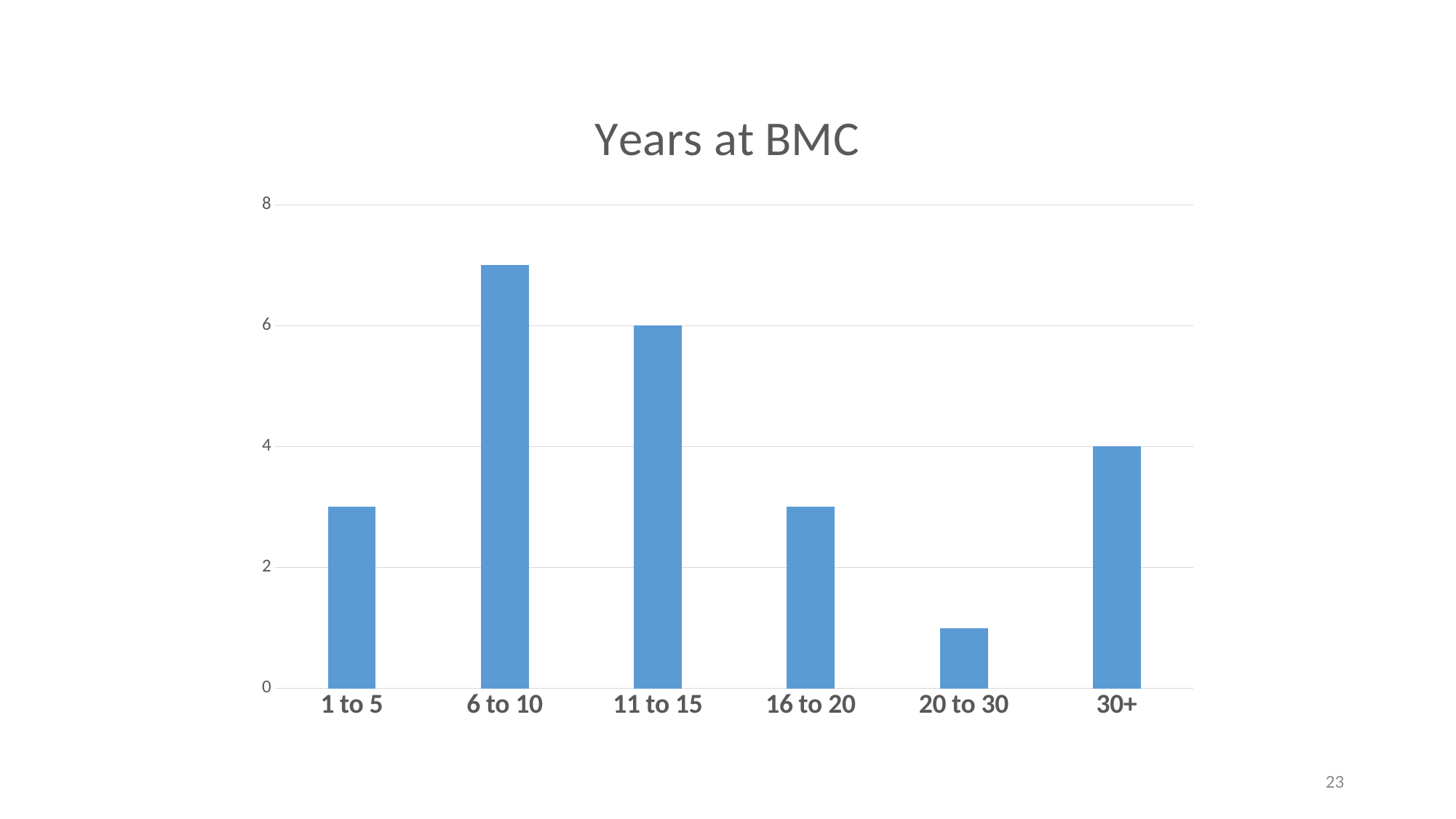
Is the value for 1 to 5 greater or less than 4? less What type of chart is shown on the slide? bar chart Which category has the highest value? 6 to 10 Which category has the lowest value? 20 to 30 Which is larger, the value for 1 to 5 or the value for 30+? 30+ Is the value for 6 to 10 greater or less than 6? greater What is the difference between the values for 11 to 15 and 30+? 2 What is the title of the chart? Years at BMC How many categories are shown on the x axis? 6 Is the value for 20 to 30 greater or less than 2? less What is the value for 11 to 15? 6 What is the value for 30+? 4